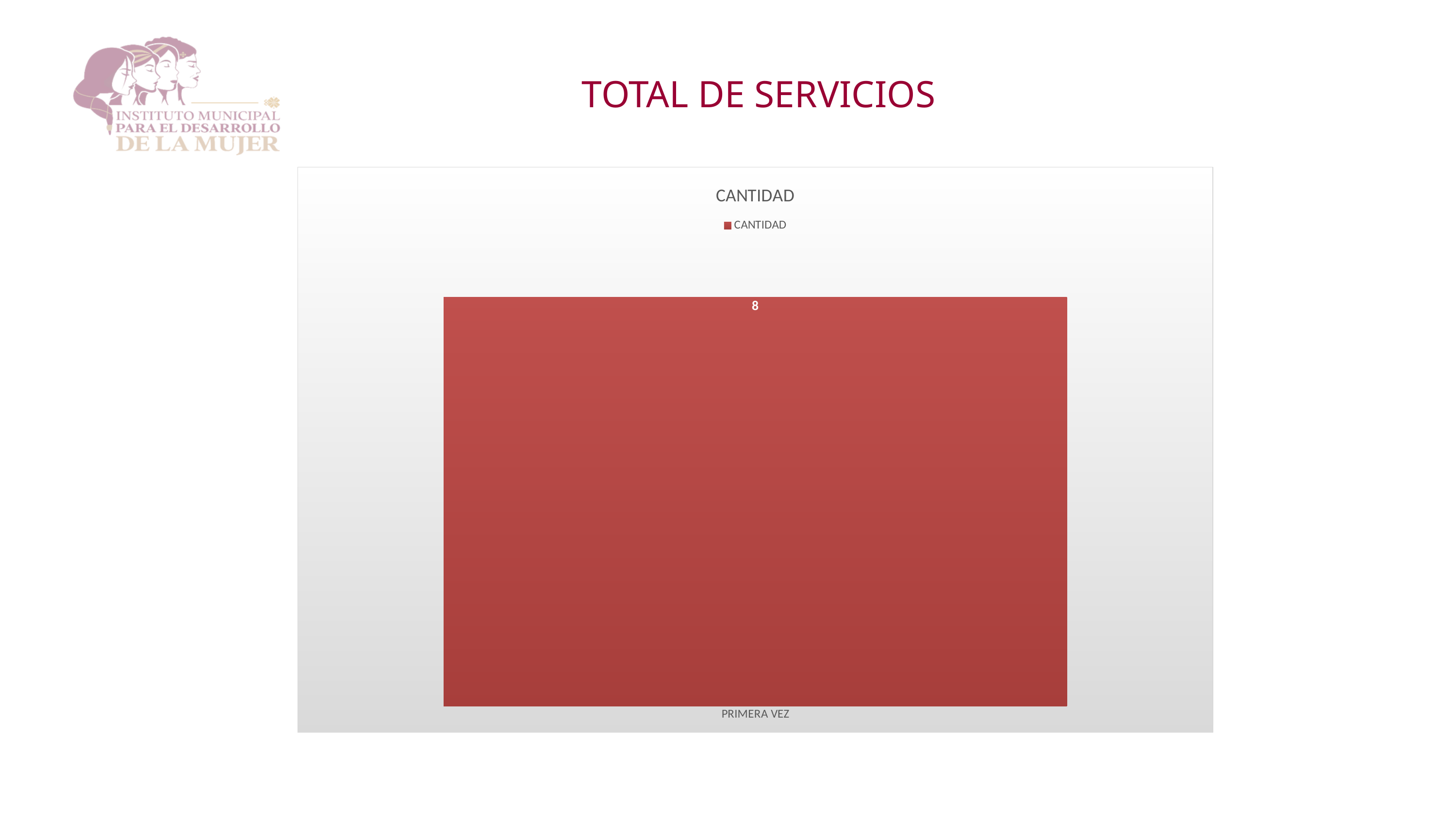
What is the name of the series listed in the chart legend? CANTIDAD What is the label of the only category on the x axis? PRIMERA VEZ How many series does the chart legend list? 1 How many categories are shown on the x axis of the chart? 1 What kind of chart is shown on the slide? bar chart What is the title of the chart? CANTIDAD What is the value for PRIMERA VEZ in the CANTIDAD chart? 8